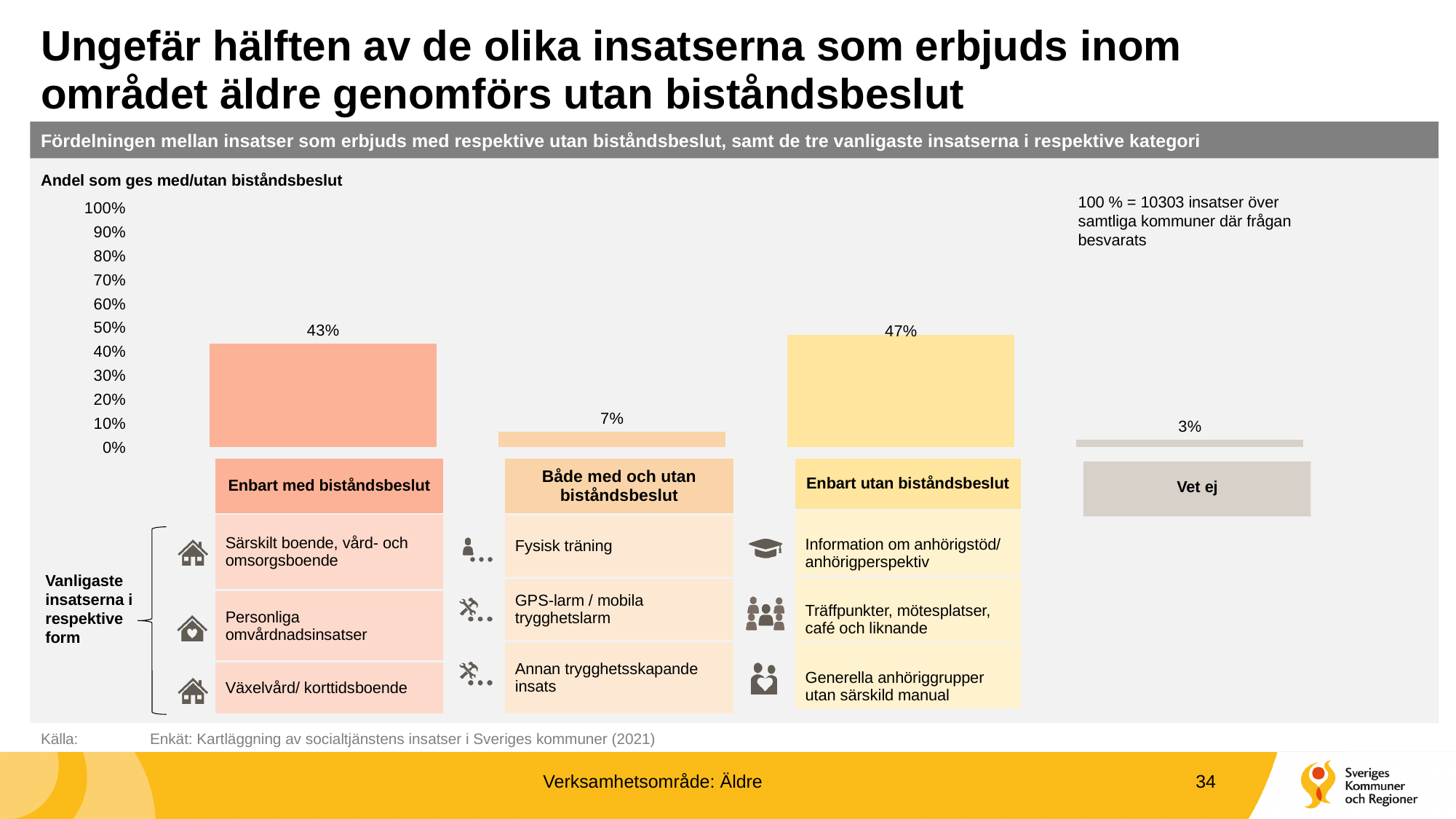
What kind of chart is shown on the slide? Bar chart According to the note on the chart, how many insatser does 100% correspond to? 10303 What is the value for "Vet ej"? 3% What is the value for "Både med och utan biståndsbeslut"? 7% What is the value for "Enbart med biståndsbeslut"? 43% Which category has the lowest value? Vet ej Is the value for "Enbart med biståndsbeslut" greater or less than 50%? less What is the difference between the values for "Enbart utan biståndsbeslut" and "Enbart med biståndsbeslut"? 4 percentage points Which category has the highest value? Enbart utan biståndsbeslut What is the value for "Enbart utan biståndsbeslut"? 47% Which is larger, the value for "Både med och utan biståndsbeslut" or the value for "Vet ej"? Både med och utan biståndsbeslut How many categories are shown in the bar chart? 4